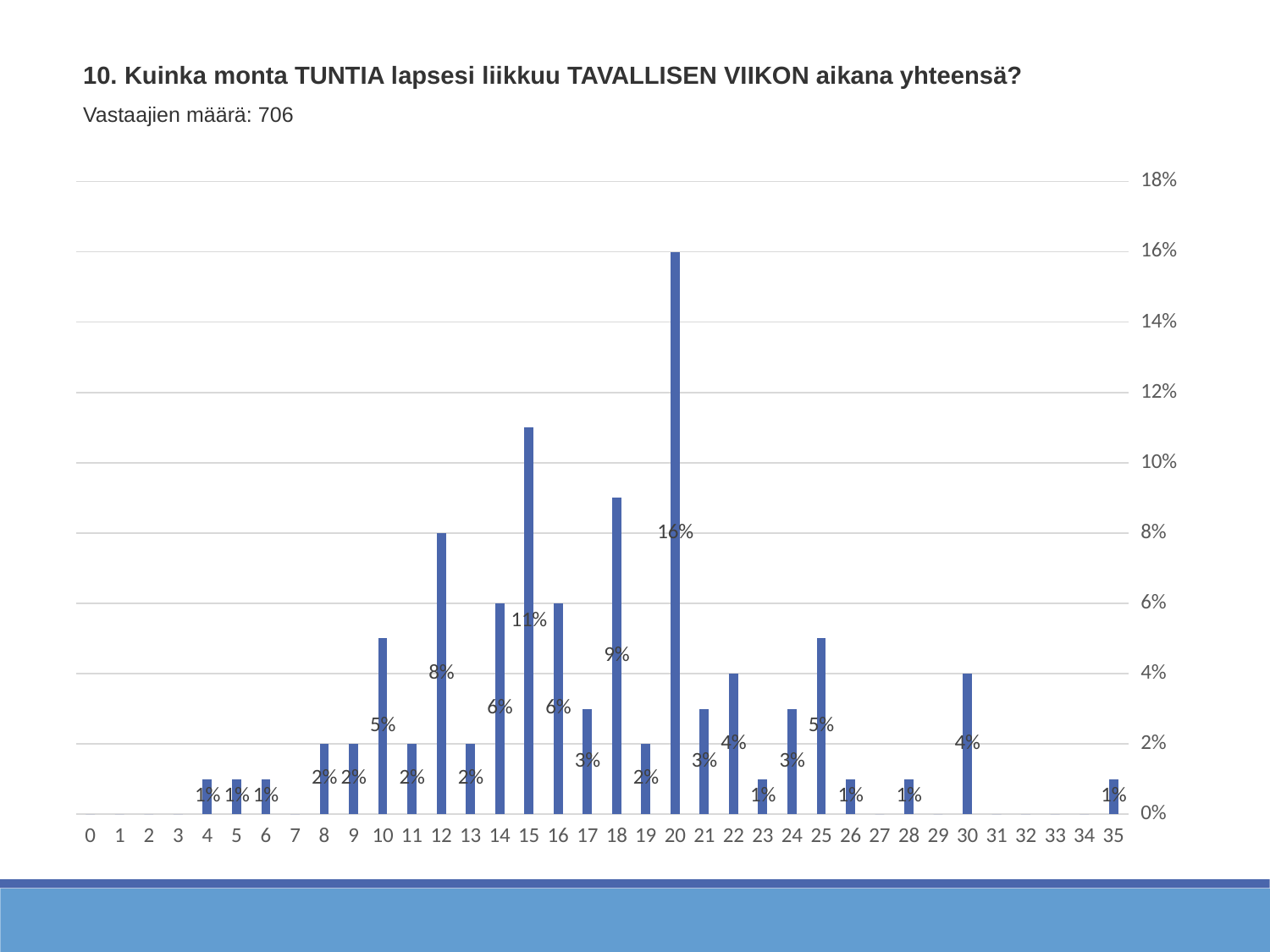
What is the value for category 12? 8% What is the number of respondents (Vastaajien määrä) stated on the slide? 706 What is the value for category 18? 9% Which category has the highest value? 20 What kind of chart is shown on the slide? bar chart How many categories are shown on the x axis? 36 Which is larger, the value for category 10 or the value for category 12? 12 What is the difference between the values for category 25 and category 30? 1% What is the value for category 20? 16% What is the value for category 15? 11% Is the value for category 18 greater or less than 8%? greater What is the difference between the values for category 20 and category 15? 5%